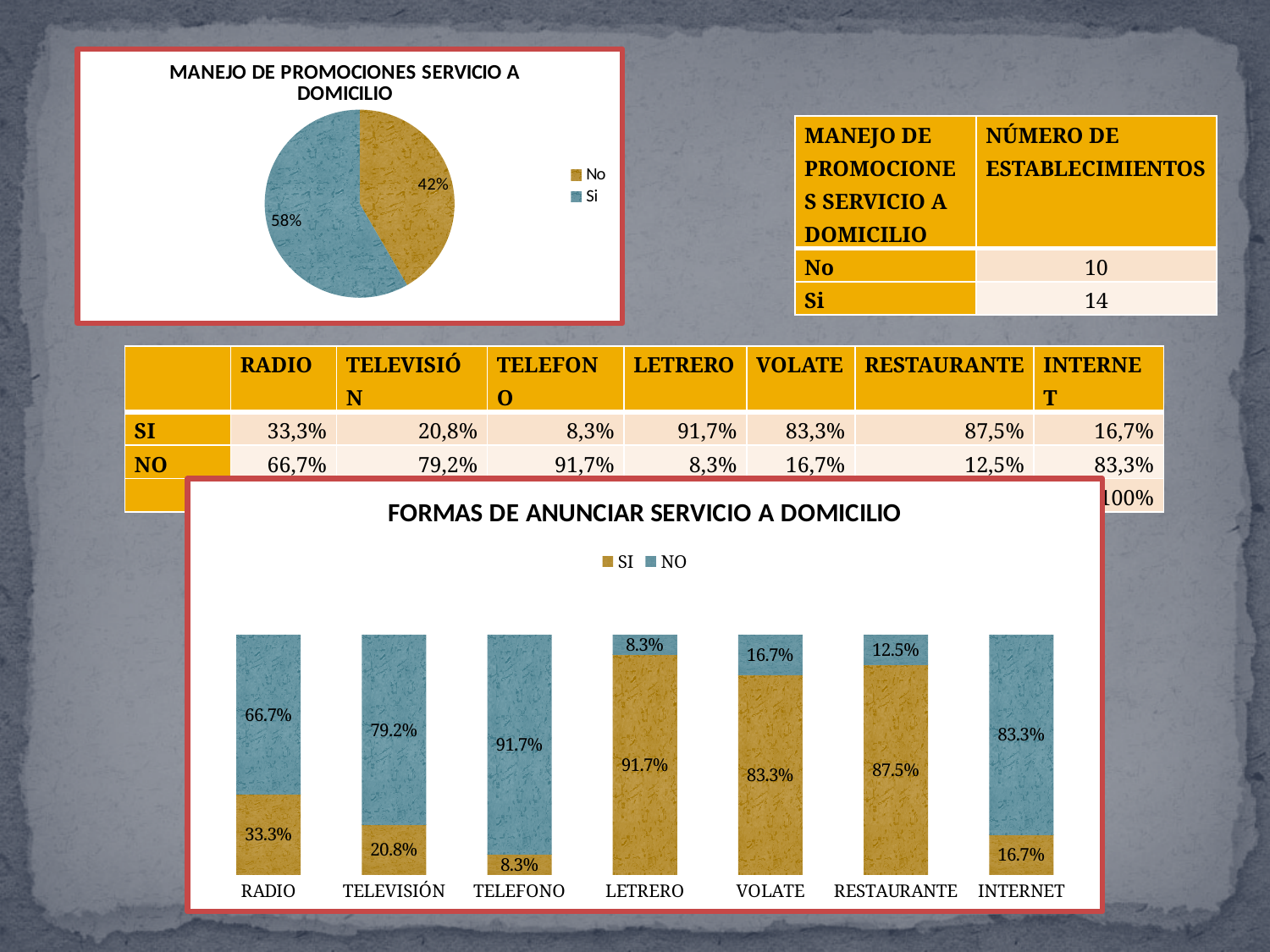
How many series does the legend of the chart 'FORMAS DE ANUNCIAR SERVICIO A DOMICILIO' list? 2 In the chart 'FORMAS DE ANUNCIAR SERVICIO A DOMICILIO', what is the difference between the SI values for RESTAURANTE and VOLATE? 4.2% How many categories are shown on the x axis of the chart 'FORMAS DE ANUNCIAR SERVICIO A DOMICILIO'? 7 In the chart 'FORMAS DE ANUNCIAR SERVICIO A DOMICILIO', which is larger, the SI value for RADIO or the SI value for INTERNET? RADIO In the pie chart 'MANEJO DE PROMOCIONES SERVICIO A DOMICILIO', what share is labelled for 'Si'? 58% In the pie chart 'MANEJO DE PROMOCIONES SERVICIO A DOMICILIO', which slice is larger, 'Si' or 'No'? Si In the pie chart 'MANEJO DE PROMOCIONES SERVICIO A DOMICILIO', what share is labelled for 'No'? 42% What kind of chart is 'FORMAS DE ANUNCIAR SERVICIO A DOMICILIO'? Stacked bar chart In the chart 'FORMAS DE ANUNCIAR SERVICIO A DOMICILIO', which category has the highest SI value? LETRERO In the chart 'FORMAS DE ANUNCIAR SERVICIO A DOMICILIO', which category has the lowest SI value? TELEFONO In the chart 'FORMAS DE ANUNCIAR SERVICIO A DOMICILIO', what is the SI value for TELEFONO? 8.3% In the chart 'FORMAS DE ANUNCIAR SERVICIO A DOMICILIO', what is the NO value for TELEVISIÓN? 79.2%